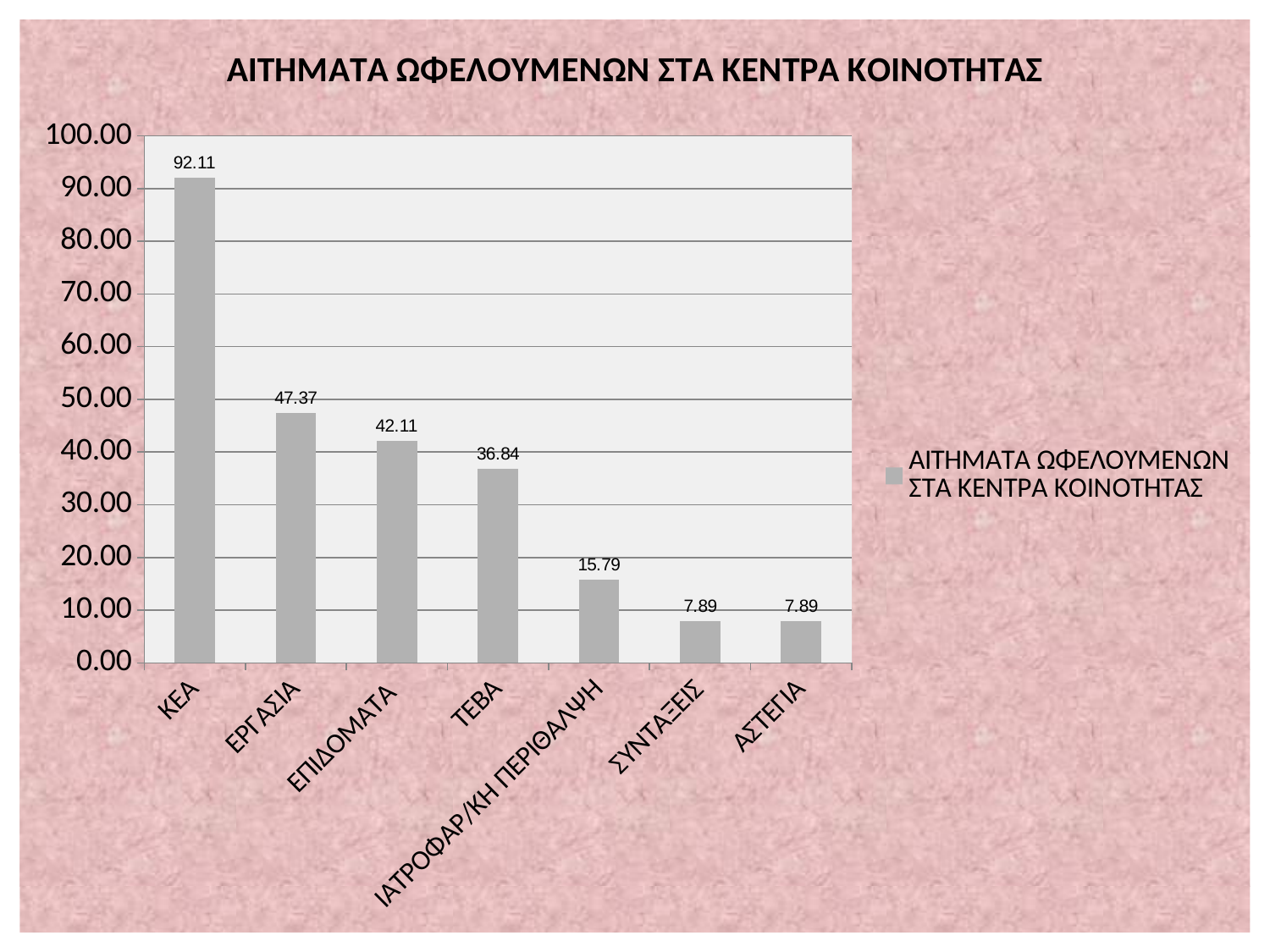
Which category has the highest value? ΚΕΑ What kind of chart is shown on the slide? bar chart What is the title of the chart? ΑΙΤΗΜΑΤΑ ΩΦΕΛΟΥΜΕΝΩΝ ΣΤΑ ΚΕΝΤΡΑ ΚΟΙΝΟΤΗΤΑΣ How many categories are shown on the x axis? 7 Which is larger, the value for ΕΠΙΔΟΜΑΤΑ or the value for ΤΕΒΑ? ΕΠΙΔΟΜΑΤΑ What is the difference between the values for ΚΕΑ and ΕΡΓΑΣΙΑ? 44.74 What is the value for ΙΑΤΡΟΦΑΡ/ΚΗ ΠΕΡΙΘΑΛΨΗ? 15.79 What is the value for ΚΕΑ? 92.11 Is the value for ΕΡΓΑΣΙΑ greater or less than 40.00? greater What is the value for ΤΕΒΑ? 36.84 What is the value for ΕΡΓΑΣΙΑ? 47.37 What is the difference between the values for ΕΠΙΔΟΜΑΤΑ and ΤΕΒΑ? 5.27